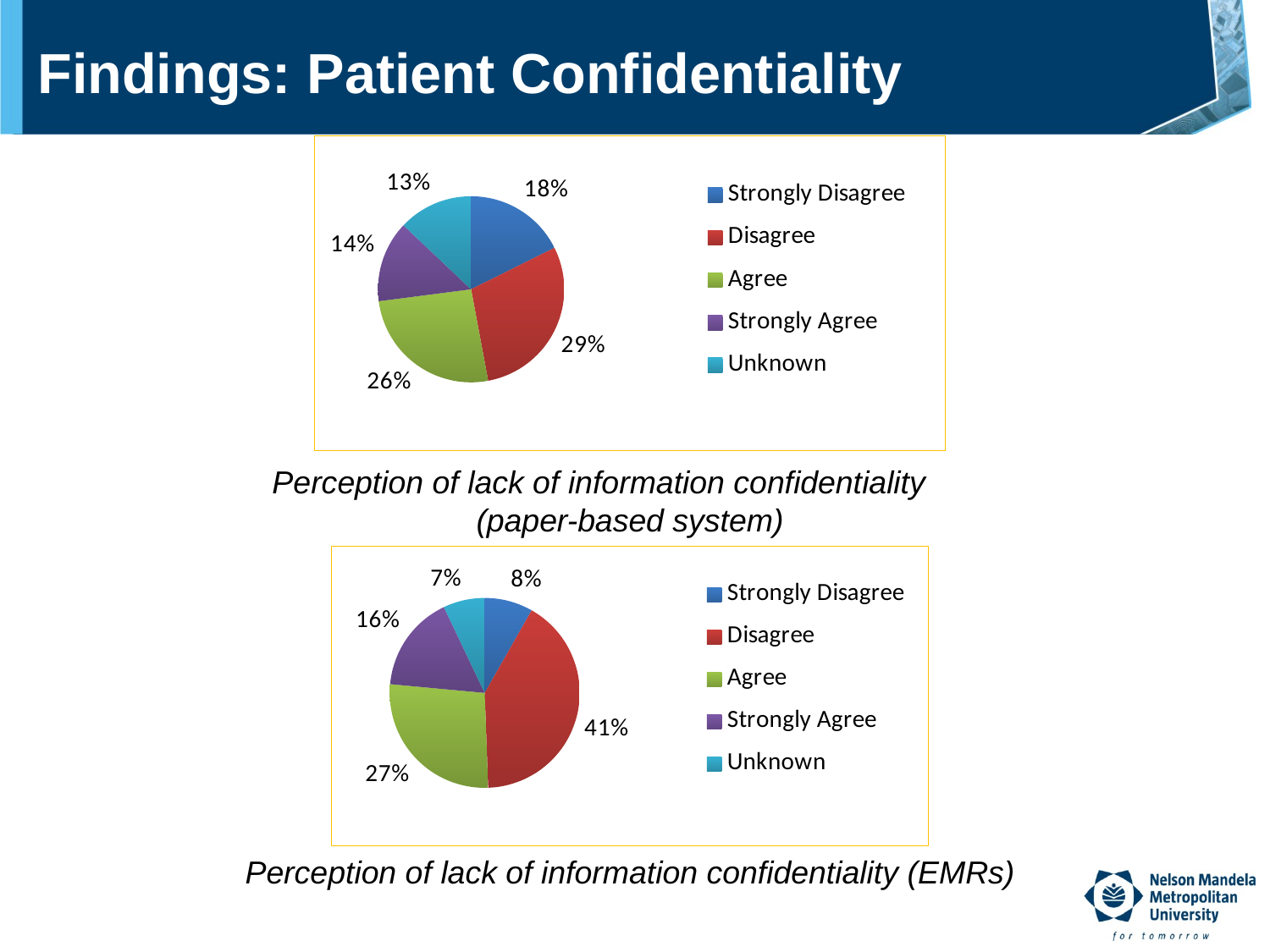
How many categories does the legend of the top chart (paper-based system) list? 5 In the bottom chart (EMRs), what percentage is shown for Strongly Agree? 16% In the top chart (paper-based system), which category has the largest share? Disagree What type of chart is used in the bottom chart (EMRs)? Pie chart In the top chart (paper-based system), what percentage is shown for Unknown? 13% In the bottom chart (EMRs), what is the combined share of Agree and Strongly Agree? 43% In the top chart (paper-based system), which category has the smallest share? Unknown In the bottom chart (EMRs), what percentage of respondents chose Disagree? 41% In the bottom chart (EMRs), which is larger, the Agree share or the Strongly Agree share? Agree In the top chart (paper-based system), what is the difference between the Disagree and Strongly Disagree shares? 11% In the bottom chart (EMRs), which category has the smallest share? Unknown In the top chart (paper-based system), what percentage of respondents chose Disagree? 29%